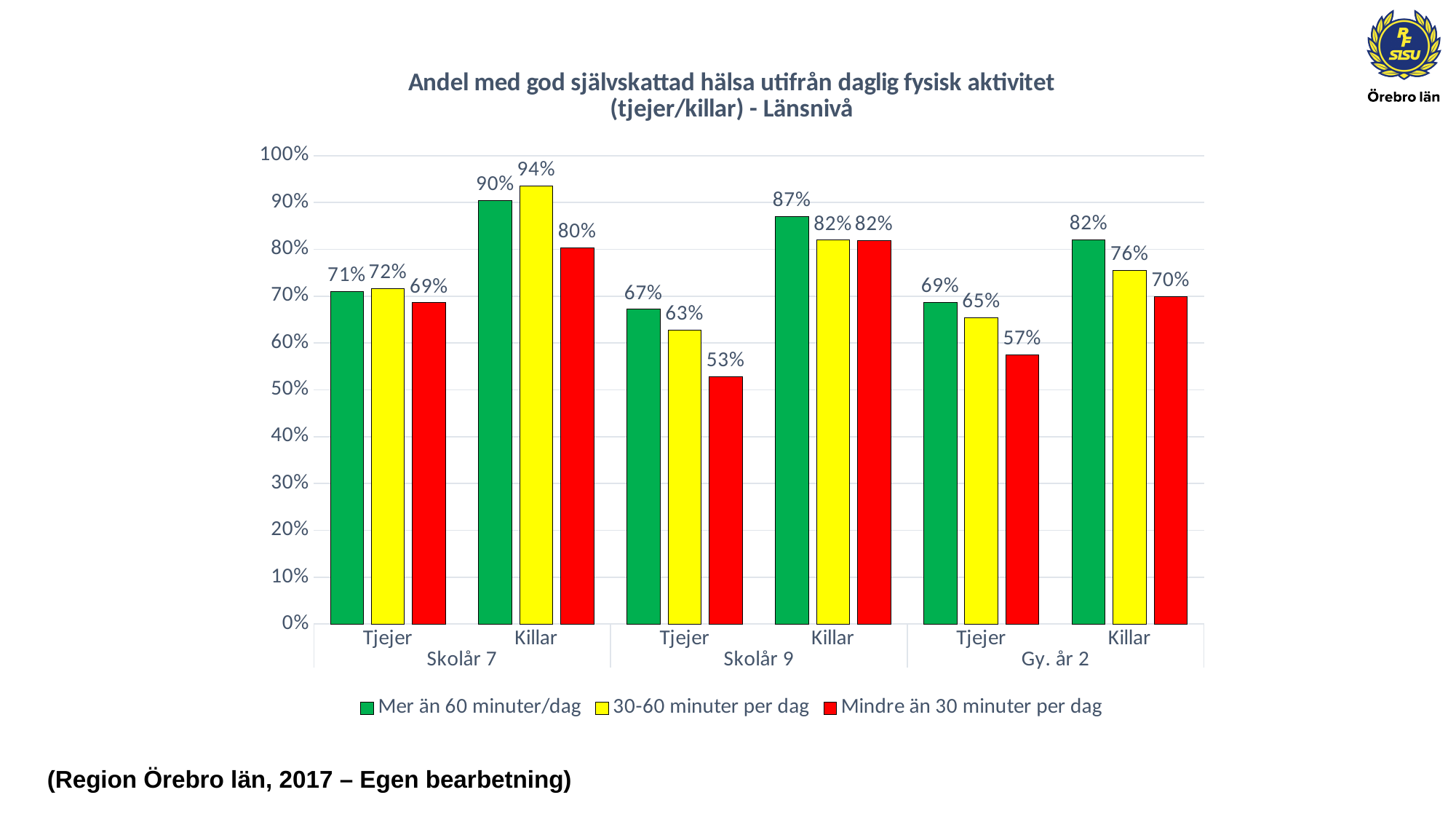
Which colour represents the series 'Mindre än 30 minuter per dag'? red Which group has the lowest value for the series 'Mindre än 30 minuter per dag'? Tjejer, Skolår 9 What is the value for Tjejer in Skolår 9 for the series 'Mindre än 30 minuter per dag'? 53% How many groups (category positions) are shown along the x axis? 6 What type of chart is shown on the slide? bar chart What is the difference between the 'Mer än 60 minuter/dag' values for Killar and Tjejer in Skolår 9? 20% What is the value for Killar in Gy. år 2 for the series '30-60 minuter per dag'? 76% How many series does the legend list? 3 What is the difference between the 'Mindre än 30 minuter per dag' values for Killar in Skolår 7 and Killar in Gy. år 2? 10% What is the value for Killar in Skolår 7 for the series 'Mer än 60 minuter/dag'? 90% Which group has the highest value for the series '30-60 minuter per dag'? Killar, Skolår 7 For Tjejer in Gy. år 2, which is larger: 'Mer än 60 minuter/dag' or 'Mindre än 30 minuter per dag'? Mer än 60 minuter/dag